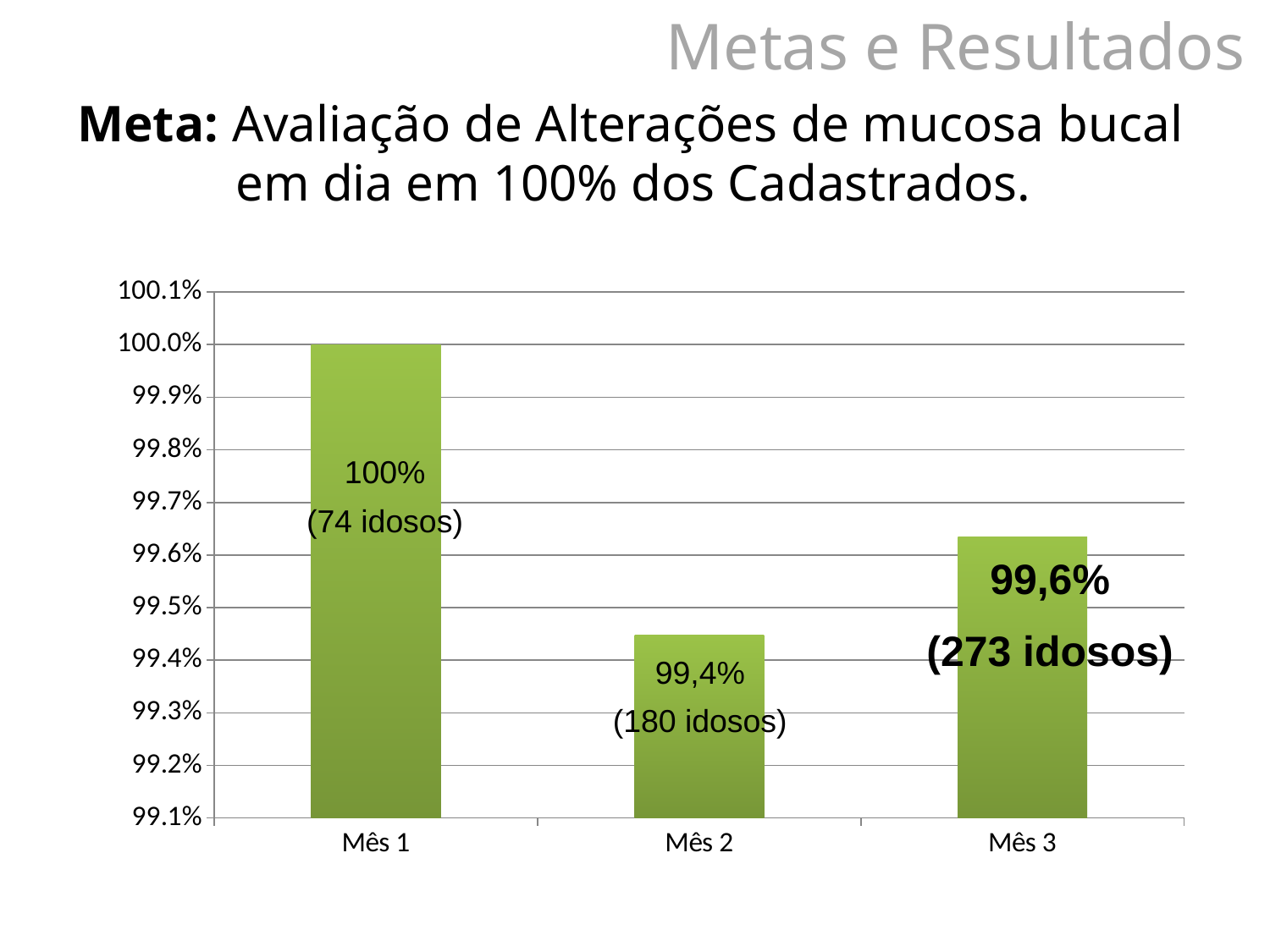
Which is larger, the percentage for Mês 2 or for Mês 3? Mês 3 How many categories (months) are plotted in the chart? 3 Which month has the lowest percentage? Mês 2 Which month has the highest percentage? Mês 1 Do the values rise or fall from Mês 1 to Mês 2? fall What kind of chart is shown on the slide? bar chart How many idosos are indicated for Mês 2? 180 idosos What percentage is shown for Mês 2? 99,4% Is the value for Mês 2 greater or less than 99.5%? less What percentage is shown for Mês 3? 99,6% How many idosos are indicated for Mês 3? 273 idosos What percentage is shown for Mês 1? 100%